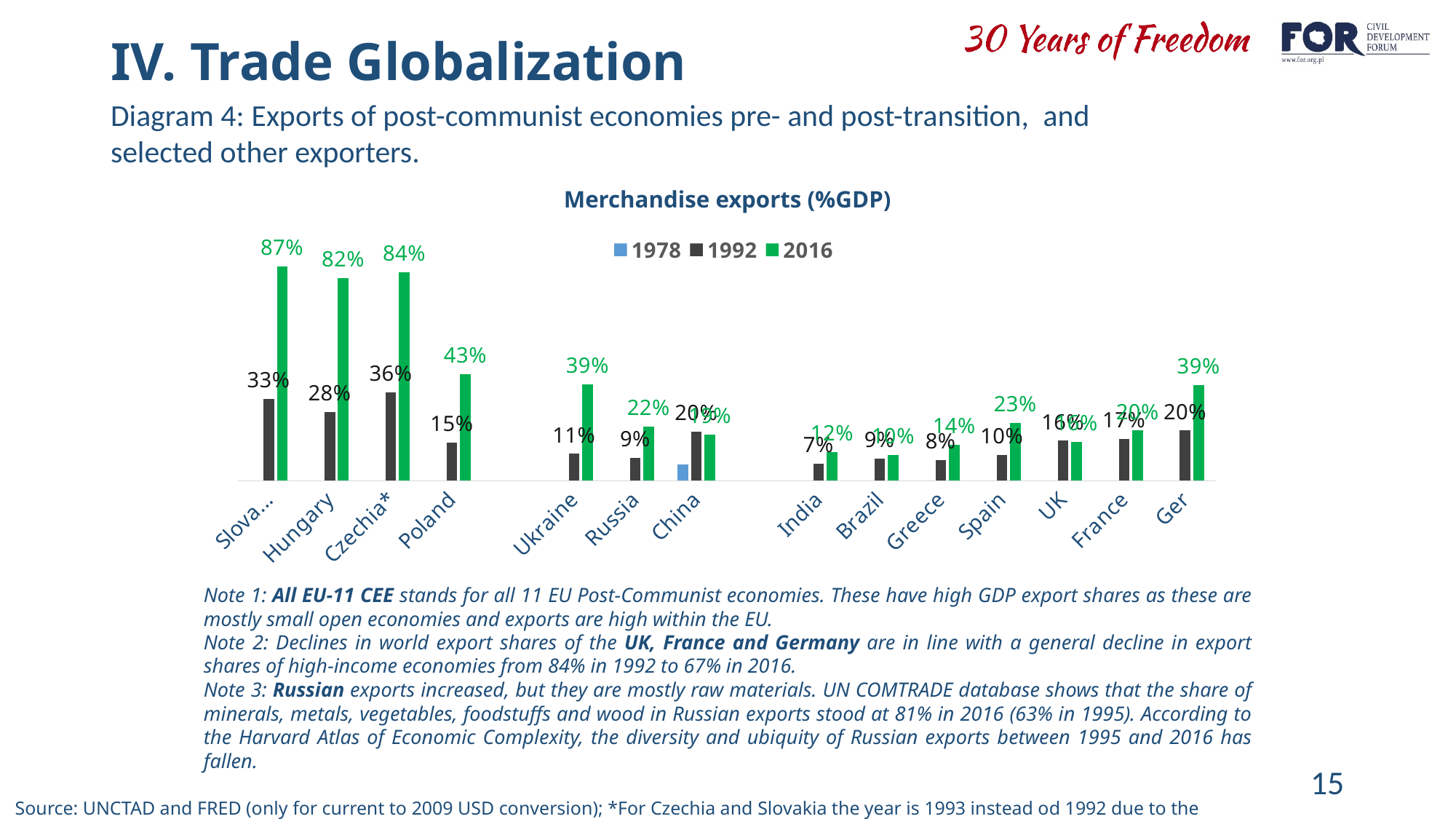
What is the title of the chart? Merchandise exports (%GDP) Which category has the highest 1992 value? Czechia* Which category has the lowest 1992 value? India Which is larger, the 2016 value for Ukraine or the 2016 value for Spain? Ukraine What is the 1992 value for Poland? 15% How many categories are shown on the x axis? 14 What kind of chart is shown? Bar chart What is the 2016 value for Ger? 39% What is the 2016 value for Russia? 22% How many series does the legend list? 3 By how many percentage points did Poland's value rise from 1992 to 2016? 28 percentage points What is the 2016 value for Hungary? 82%